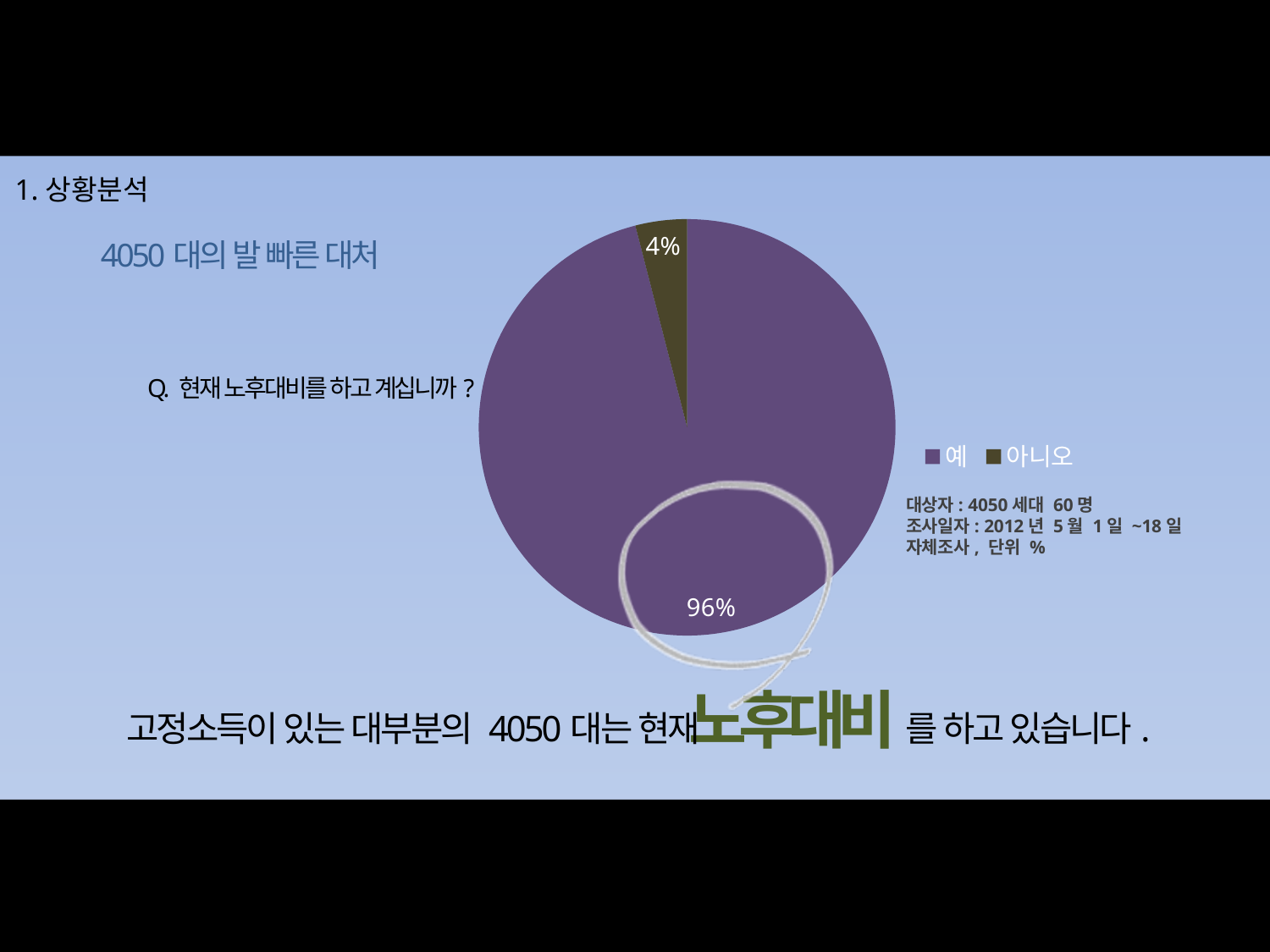
Which category has the largest share of the pie? 예 What kind of chart is shown on the slide? pie chart What percentage of the pie is labelled for 아니오 (no)? 4% What percentage of the pie is labelled for 예 (yes)? 96% What is the difference in percentage points between the 예 slice and the 아니오 slice? 92 What colour is the 예 slice in the pie chart? purple How many slices does the pie chart have? 2 What survey question does the pie chart answer? Q. 현재 노후대비를 하고 계십니까? Which category has the smallest share of the pie? 아니오 Which slice is larger, 예 or 아니오? 예 How many entries does the legend list? 2